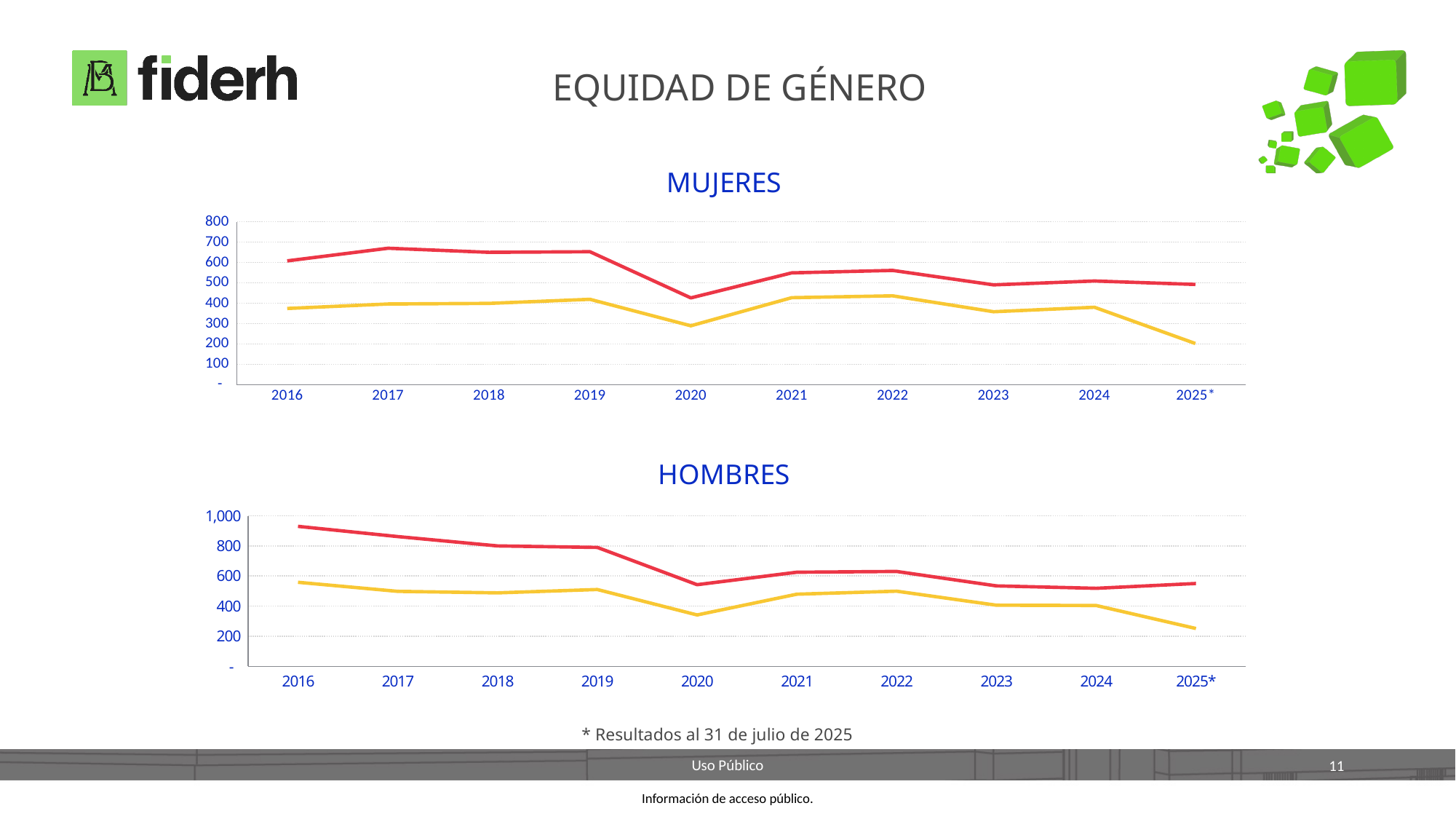
In the HOMBRES chart, does the red line rise or fall from 2016 to 2019? fall How many years are shown on the x axis of the HOMBRES chart? 10 What kind of chart is the MUJERES chart? line chart In the HOMBRES chart, is the value of the red line in 2016 greater or less than 800? greater In the MUJERES chart, is the value of the yellow line in 2025* greater or less than 300? less In the HOMBRES chart, in which year does the yellow line reach its lowest value? 2025* In the MUJERES chart, is the value of the red line in 2016 greater or less than 500? greater In the MUJERES chart, in which year does the yellow line reach its lowest value? 2025* In the HOMBRES chart, which line has the larger value in 2016, the red line or the yellow line? the red line In the MUJERES chart, in which year does the red line reach its highest value? 2017 In the HOMBRES chart, in which year does the red line reach its highest value? 2016